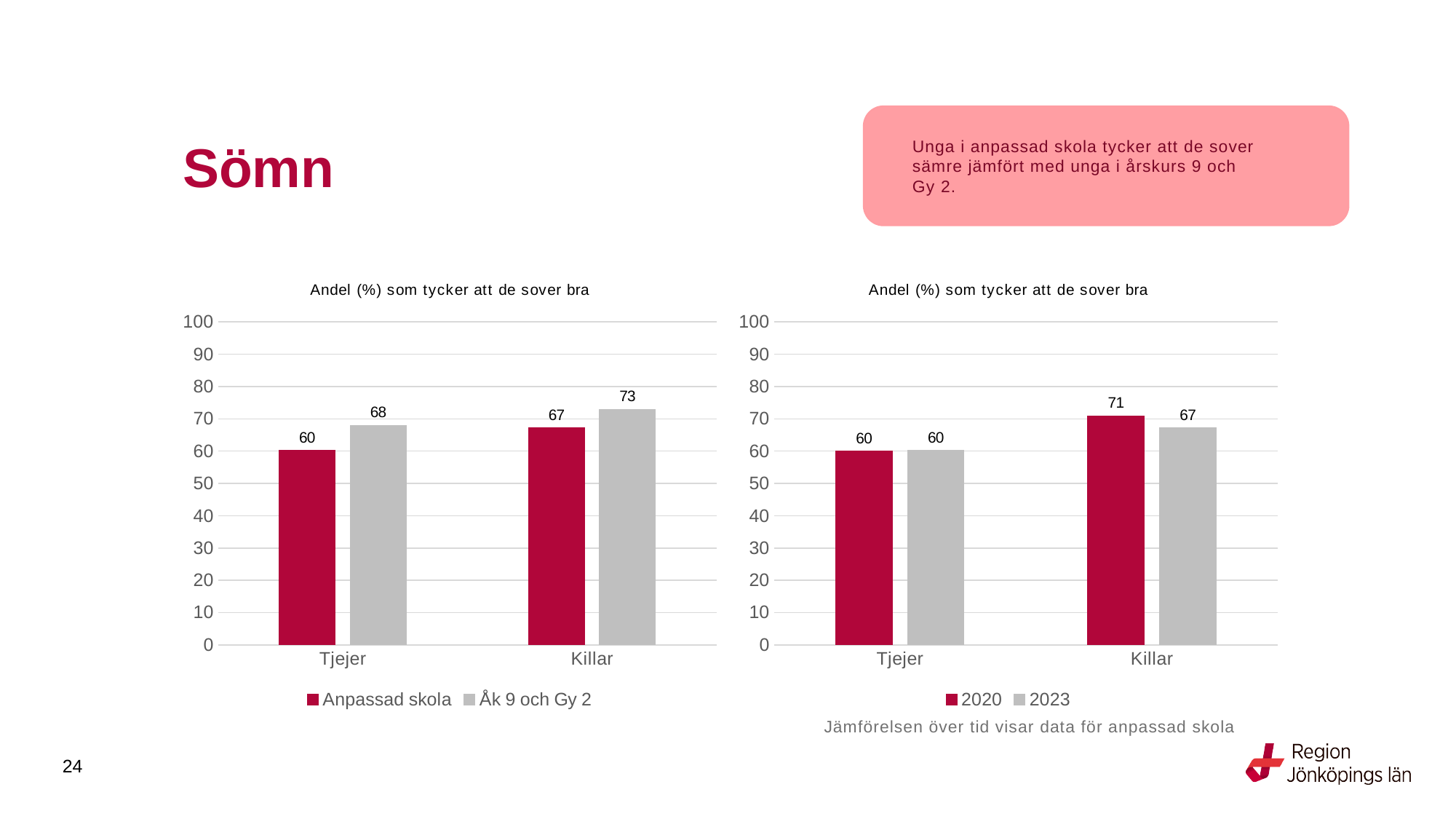
What kind of chart is the left chart? Bar chart In the right chart, what is the value for Tjejer in 2023? 60 In the left chart, which category has the highest value in the Åk 9 och Gy 2 series? Killar In the right chart, which is larger for Killar: the 2020 value or the 2023 value? 2020 In the left chart, is the Anpassad skola value for Killar greater or less than 60? greater In the left chart, what is the difference between the Åk 9 och Gy 2 value and the Anpassad skola value for Tjejer? 8 What is the title of the right chart? Andel (%) som tycker att de sover bra In the left chart, what is the value for Killar in the Åk 9 och Gy 2 series? 73 In the left chart, what is the value for Tjejer in the Anpassad skola series? 60 How many series does the legend of the right chart list? 2 In the right chart, what is the difference between the 2020 and 2023 values for Killar? 4 In the right chart, what is the value for Killar in 2020? 71